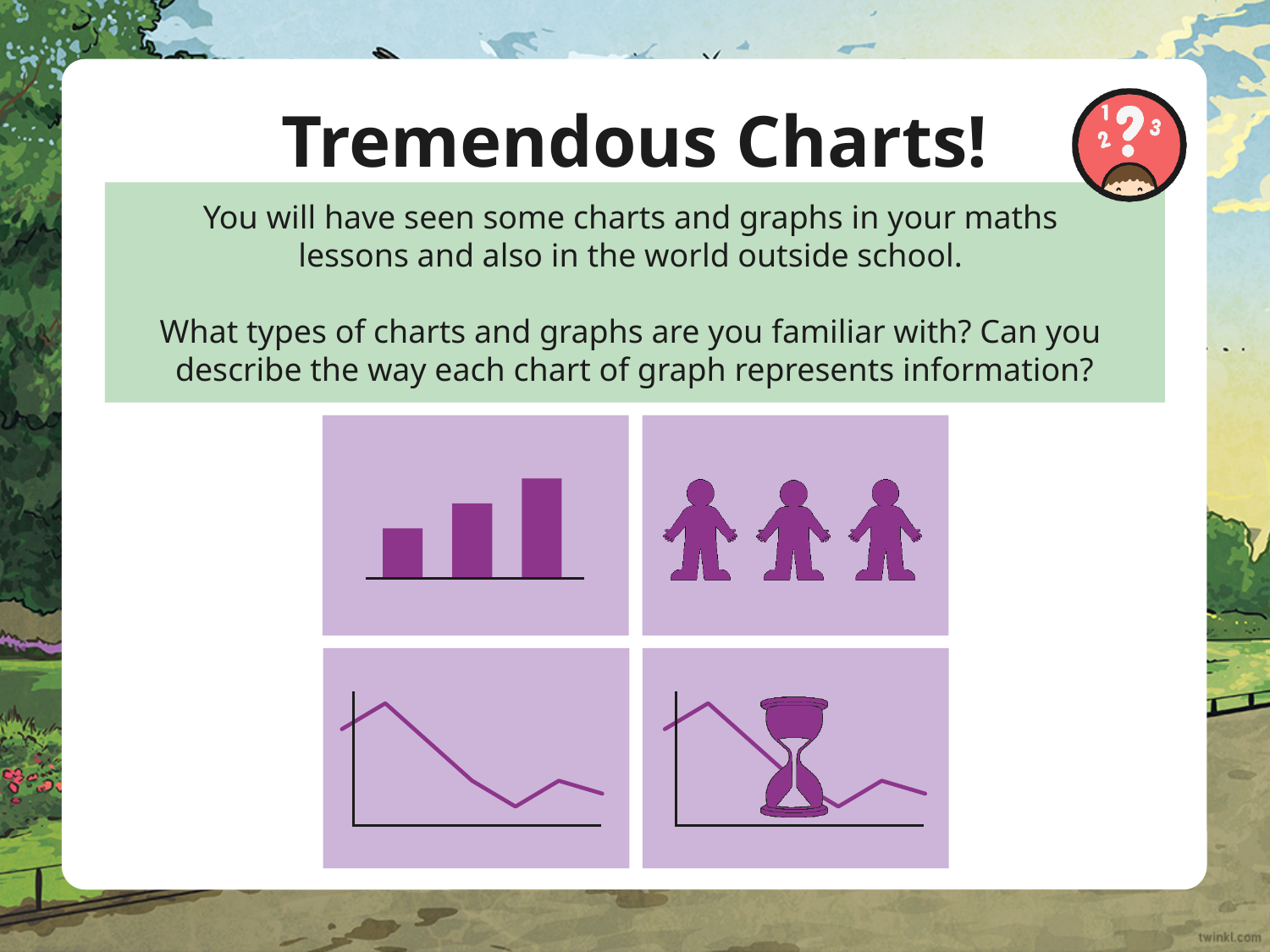
In the top-left bar chart icon, which bar is the tallest: the left, middle or right one? right In the top-left bar chart icon, which bar is the shortest: the left, middle or right one? left What kind of chart is shown in the bottom-left icon on the slide? line chart How many chart icons are shown in the purple panels on the slide? 4 How many person symbols are shown in the top-right pictogram icon? 3 What colour are the bars in the top-left bar chart icon? purple How many bars are in the bar chart icon in the top-left panel? 3 In the top-left bar chart icon, do the bars rise or fall from left to right? rise What kind of chart is shown in the top-left icon on the slide? bar chart